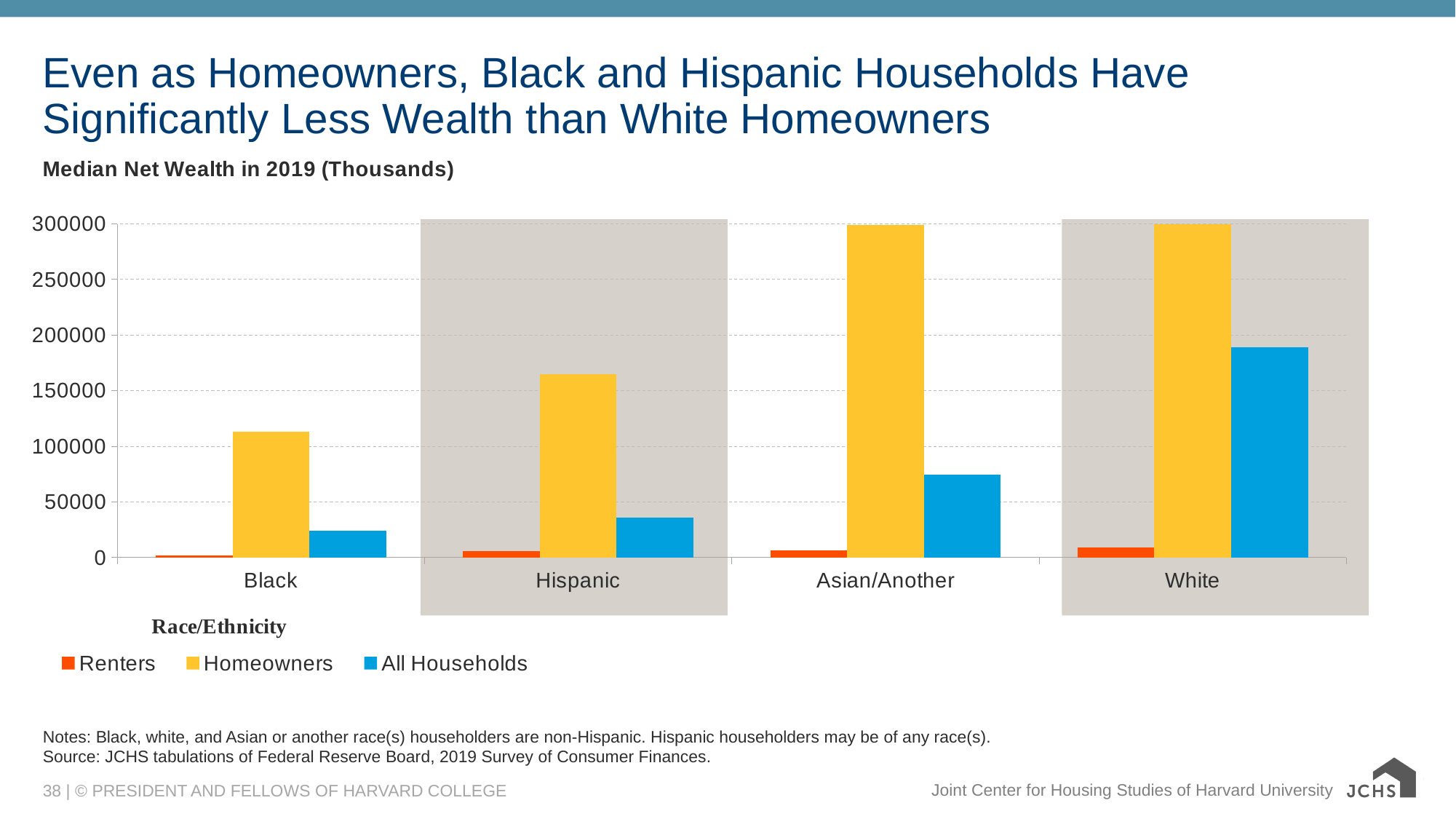
What kind of chart is shown on the slide? bar chart Is the Homeowners value for Black households greater or less than 100000? greater Which race/ethnicity category has the highest median net wealth for All Households? White Which is larger: the Homeowners value for Hispanic households or the Homeowners value for Black households? Hispanic Which race/ethnicity category has the lowest median net wealth for Homeowners? Black Is the All Households value for White households greater or less than 200000? less What is the subtitle of the chart? Median Net Wealth in 2019 (Thousands) Which race/ethnicity category has the lowest median net wealth for Renters? Black How many race/ethnicity categories are shown on the x axis? 4 How many series does the legend list? 3 Is the Homeowners value for Hispanic households greater or less than 150000? greater